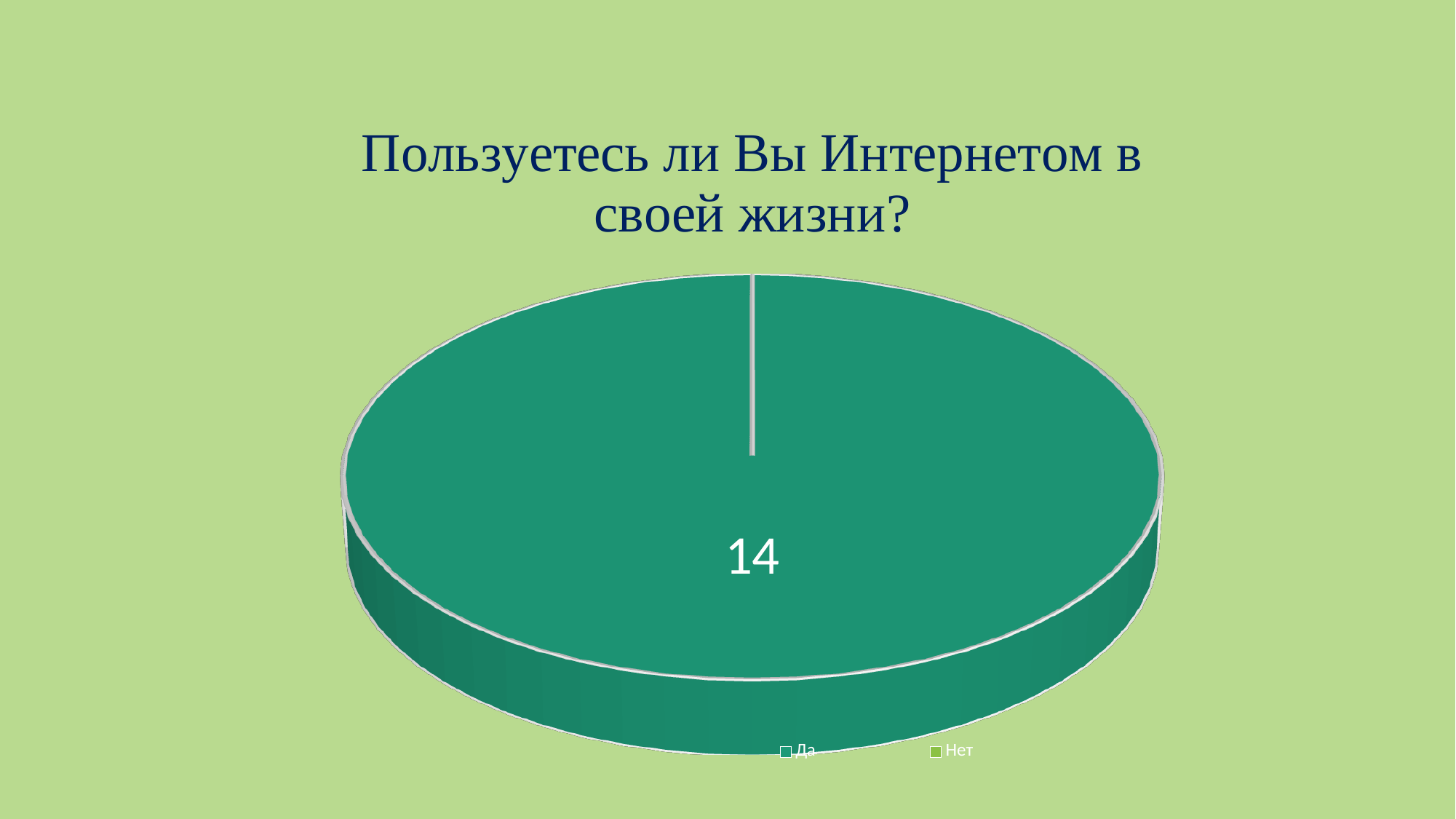
What are the two legend entries of the chart? Да, Нет How many data labels are printed on the pie chart? 1 How many entries does the chart legend list? 2 What kind of chart is shown on the slide? pie chart What value is printed as the data label on the pie chart? 14 What is the title of the chart? Пользуетесь ли Вы Интернетом в своей жизни?